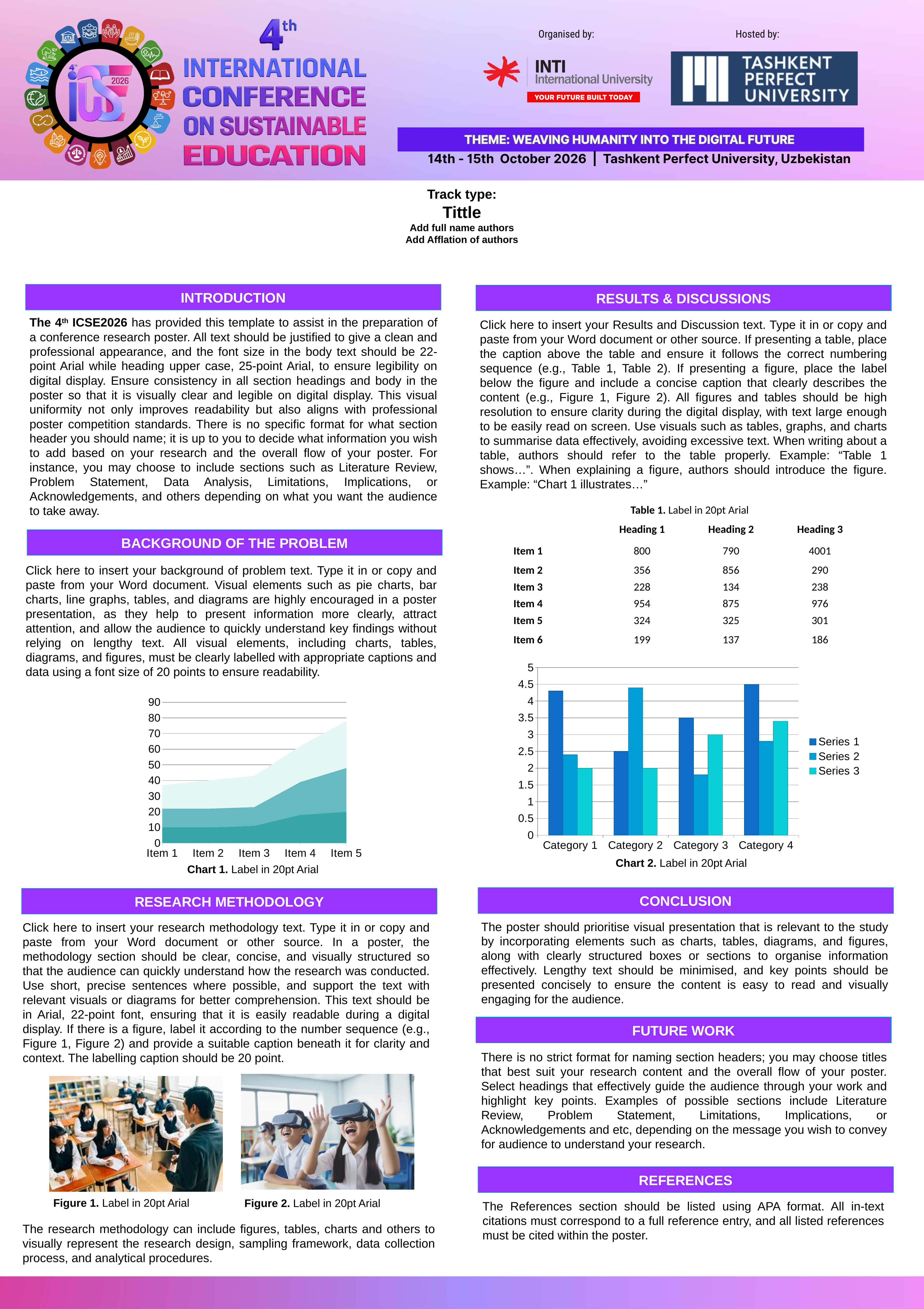
What kind of chart is Chart 1 on the left side of the slide? area chart What kind of chart is Chart 2 (Label in 20pt Arial) on the right side of the slide? bar chart In Chart 2, what is the value of Series 1 for Category 2? 2.5 In Chart 2, which category has the lowest Series 2 value? Category 3 In Chart 2, which category has the highest Series 1 value? Category 4 In Chart 2, is the value of Series 2 for Category 2 greater or less than 4? greater In Chart 2, what is the value of Series 3 for Category 3? 3 In Chart 1, does the total height of the stacked areas rise or fall from Item 3 to Item 5? rise In Chart 1, how many items are shown on the x axis? 5 In Chart 2, what is the value of Series 1 for Category 4? 4.5 In Chart 2, how many categories are shown on the x axis? 4 In Chart 2, how many series does the legend list? 3